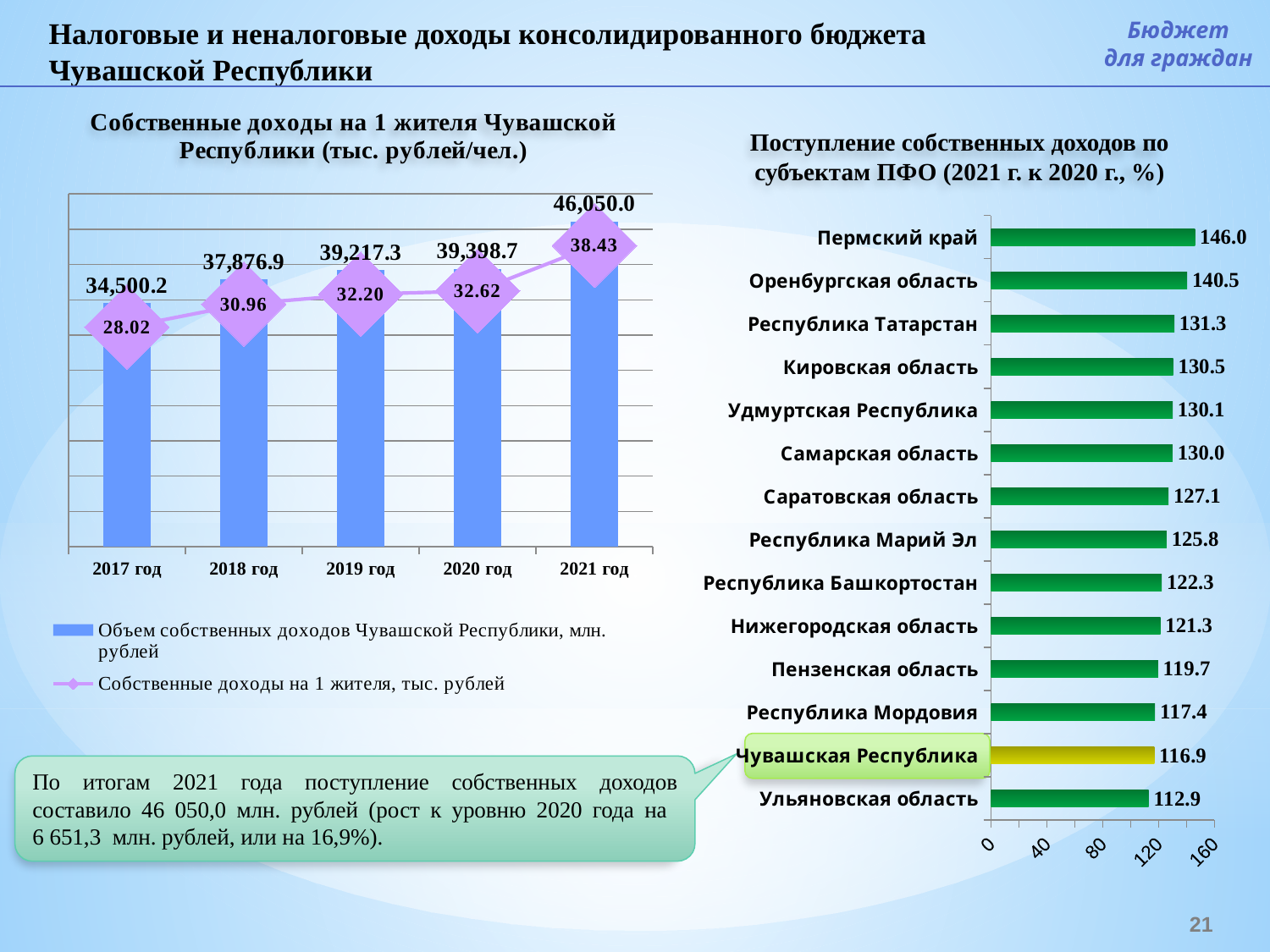
On the left chart, by how much did the bar value increase from 2020 год to 2021 год? 6,651.3 On the right chart (Поступление собственных доходов по субъектам ПФО), which region has the highest value? Пермский край On the left chart, do the bar values rise or fall from 2017 год to 2021 год? rise On the right chart, which region has the lowest value? Ульяновская область What kind of chart is the right chart (Поступление собственных доходов по субъектам ПФО)? bar chart On the right chart, what is the difference between the values for Пермский край and Ульяновская область? 33.1 On the left chart (Собственные доходы на 1 жителя Чувашской Республики), what is the value of the bar for 2021 год? 46,050.0 On the right chart, which is larger: the value for Республика Татарстан or the value for Самарская область? Республика Татарстан On the left chart, what is the value of the line marker (Собственные доходы на 1 жителя) for 2017 год? 28.02 On the left chart, how many years are shown on the x axis? 5 On the left chart, how many series does the legend list? 2 On the right chart, what is the value for Чувашская Республика? 116.9